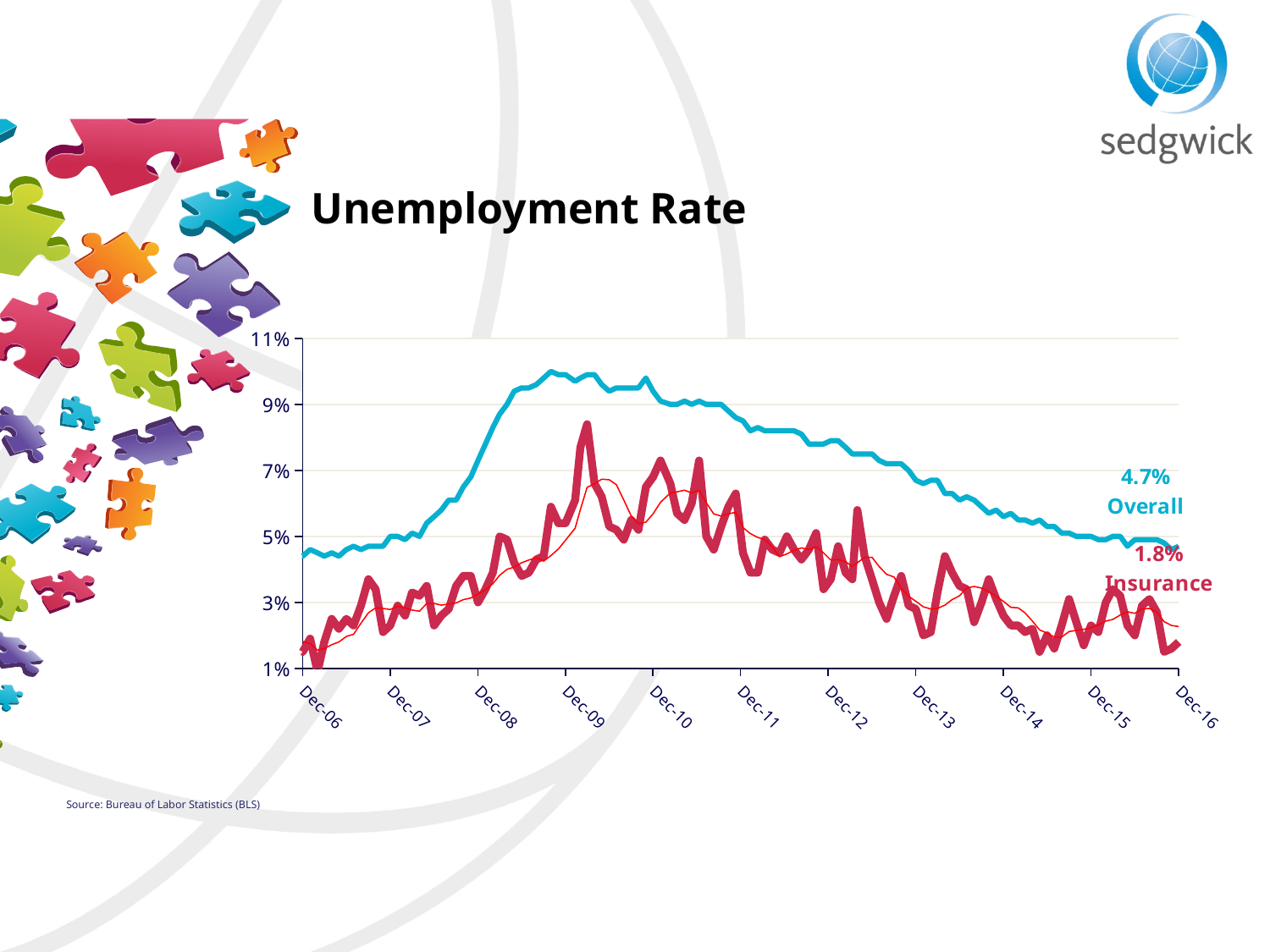
At the end of the series, which is higher: the Overall rate or the Insurance rate? Overall Is the Insurance unemployment rate at Dec-06 greater or less than 3%? less What is the title of the chart? Unemployment Rate Is the Overall unemployment rate around Dec-09 greater or less than 9%? greater What kind of chart is shown on the slide? Line chart How many year labels are shown on the x axis? 11 What is the labelled value of the Overall unemployment rate at the end of the series (Dec-16)? 4.7% What is the difference between the labelled Overall rate (4.7%) and the labelled Insurance rate (1.8%) at the end of the series? 2.9% Does the Overall unemployment rate rise or fall between Dec-09 and Dec-16? fall What is the labelled value of the Insurance unemployment rate at the end of the series (Dec-16)? 1.8% What source is cited for the chart data? Bureau of Labor Statistics (BLS) Is the Overall unemployment rate at Dec-06 greater or less than 5%? less